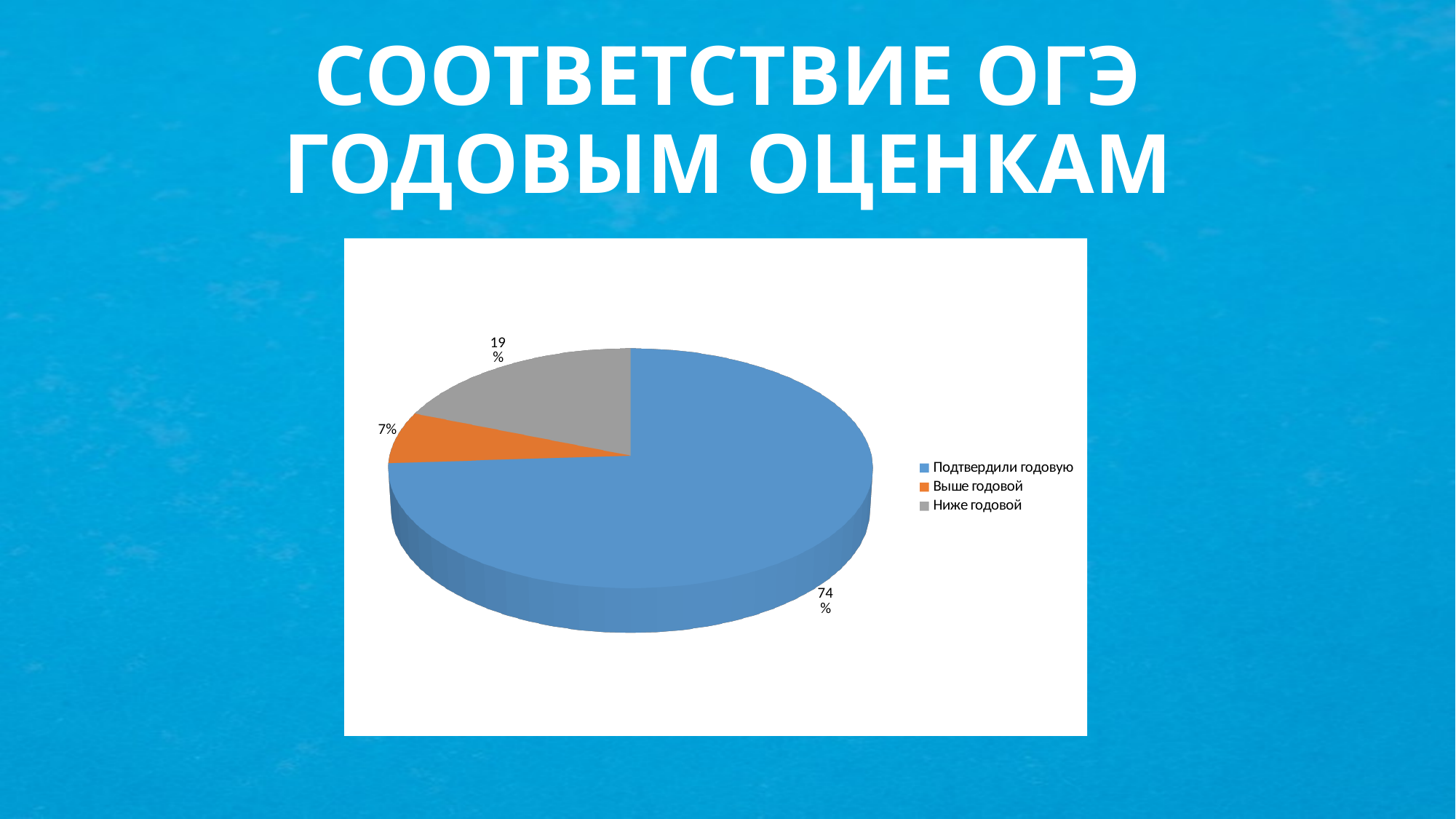
Which category has the largest slice of the pie? Подтвердили годовую What share of the pie does "Подтвердили годовую" represent? 74% How many categories does the pie chart show? 3 What is the title of the slide containing the chart? СООТВЕТСТВИЕ ОГЭ ГОДОВЫМ ОЦЕНКАМ Which is larger: the slice for "Ниже годовой" or the slice for "Выше годовой"? Ниже годовой What is the difference in percentage points between "Подтвердили годовую" and "Ниже годовой"? 55 Which category has the smallest slice of the pie? Выше годовой What share of the pie does "Ниже годовой" represent? 19% What kind of chart is shown on the slide? Pie chart What share of the pie does "Выше годовой" represent? 7% What is the difference in percentage points between "Ниже годовой" and "Выше годовой"? 12 What colour is the slice for "Выше годовой"? Orange